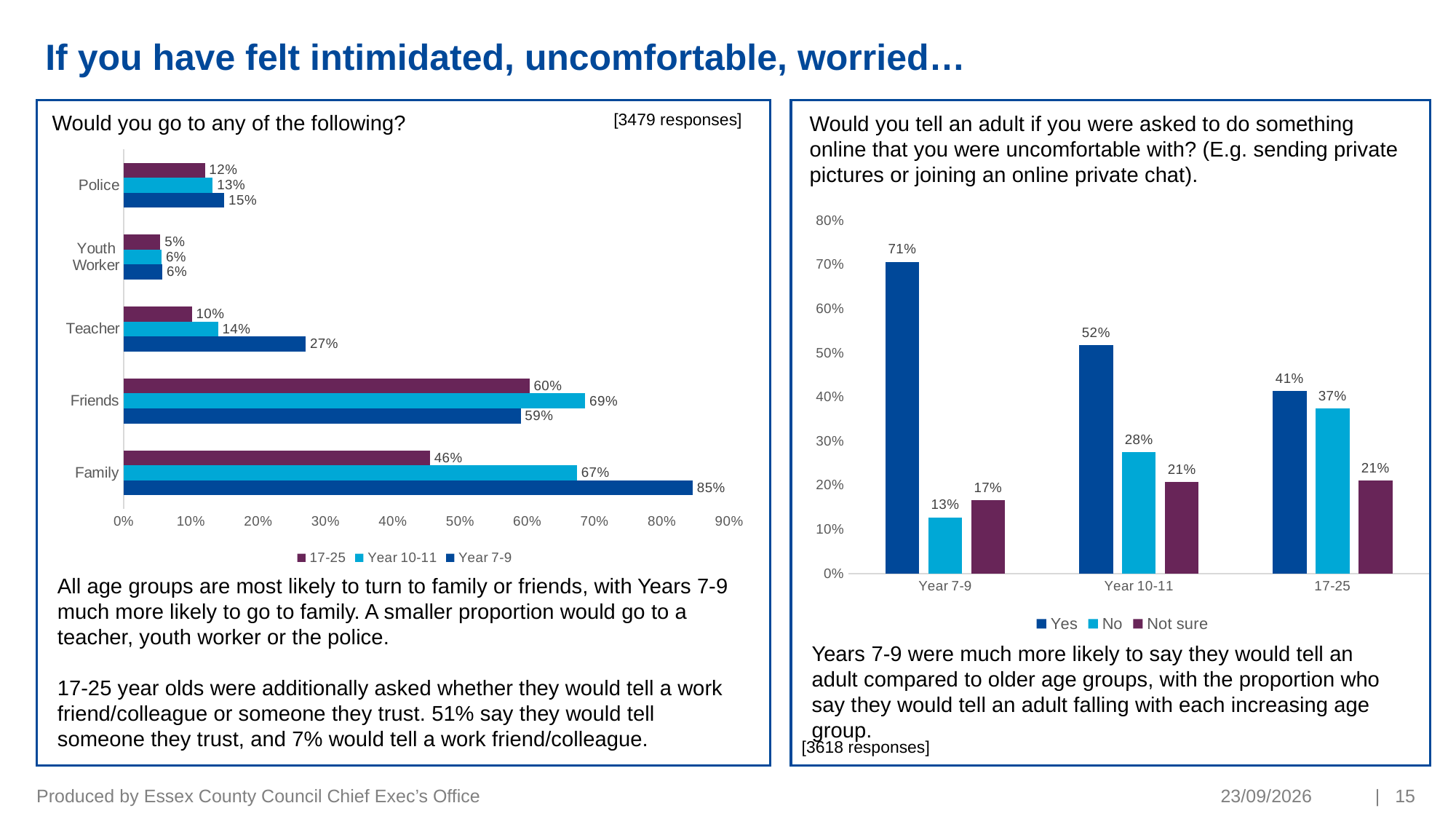
In the chart 'Would you go to any of the following?', which is larger for Teacher: the Year 7-9 value or the Year 10-11 value? Year 7-9 In the chart 'Would you go to any of the following?', what percentage of Year 7-9 would go to Family? 85% How many series does the legend list in the chart 'Would you go to any of the following?' 3 How many categories are shown in the chart 'Would you go to any of the following?' 5 In the chart 'Would you tell an adult if you were asked to do something online that you were uncomfortable with?', what percentage of 17-25 answered No? 37% In the chart 'Would you tell an adult if you were asked to do something online that you were uncomfortable with?', does the Yes value rise or fall from Year 7-9 to 17-25? Fall In the chart 'Would you tell an adult if you were asked to do something online that you were uncomfortable with?', which age group has the highest Yes value? Year 7-9 In the chart 'Would you go to any of the following?', what percentage of Year 10-11 would go to Friends? 69% In the chart 'Would you tell an adult if you were asked to do something online that you were uncomfortable with?', what percentage of Year 7-9 answered Yes? 71% In the chart 'Would you go to any of the following?', which category has the lowest value for the 17-25 series? Youth Worker In the chart 'Would you go to any of the following?', what is the difference between the Year 7-9 and 17-25 values for Family? 39% What kind of chart is the chart 'Would you tell an adult if you were asked to do something online that you were uncomfortable with?' Bar chart